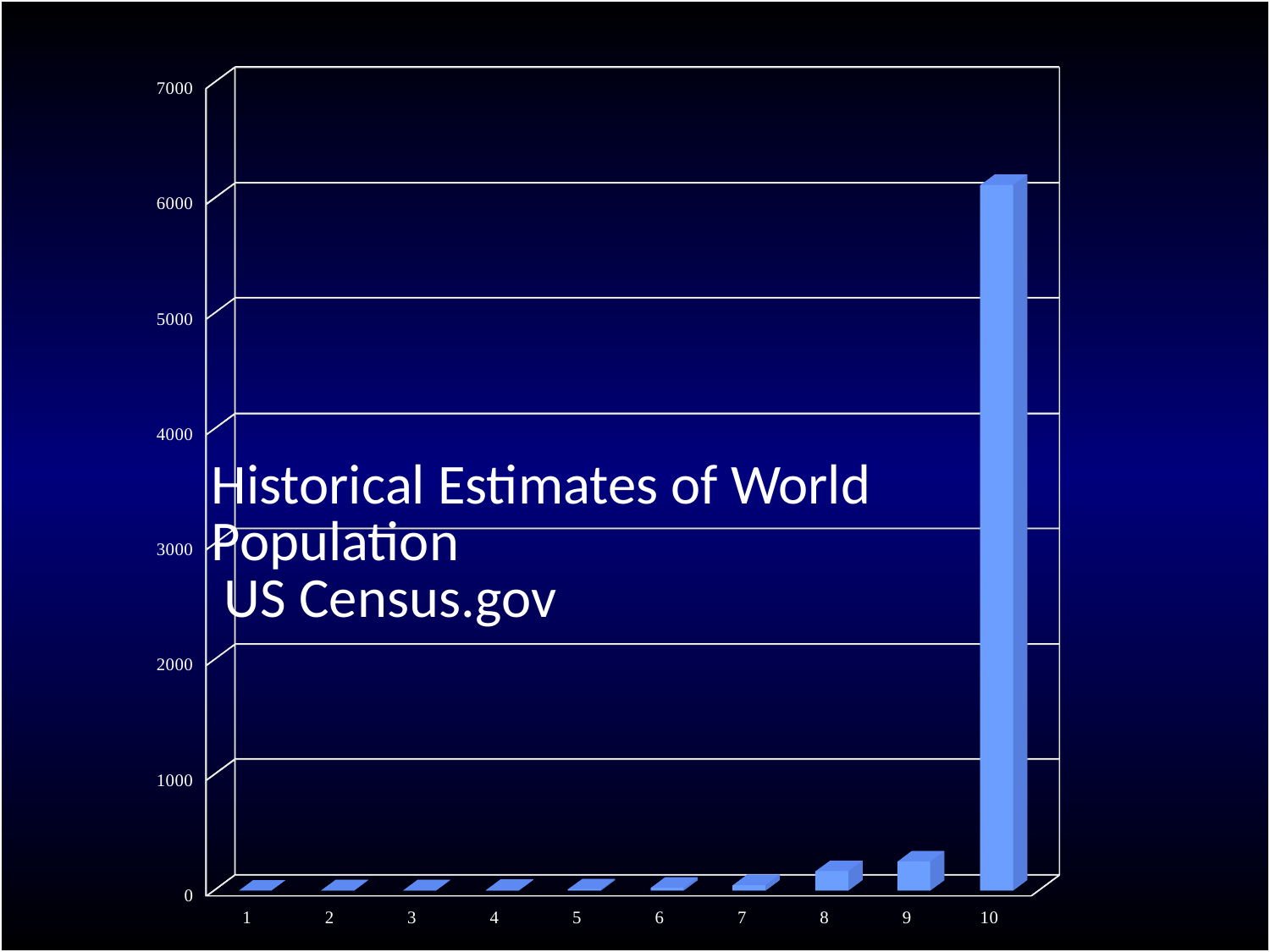
What is the title text shown on the chart? Historical Estimates of World Population US Census.gov Which is larger, the value for category 10 or the value for category 9? category 10 Is the value for category 9 greater or less than 1000? less What is the highest value labelled on the vertical axis? 7000 Which category has the highest value? 10 Is the value for category 1 greater or less than 1000? less Is the value for category 10 greater or less than 5000? greater What kind of chart is shown on the slide? bar chart Do the values generally rise or fall from category 1 to category 10? rise Which is larger, the value for category 9 or the value for category 8? category 9 How many categories are plotted along the x axis? 10